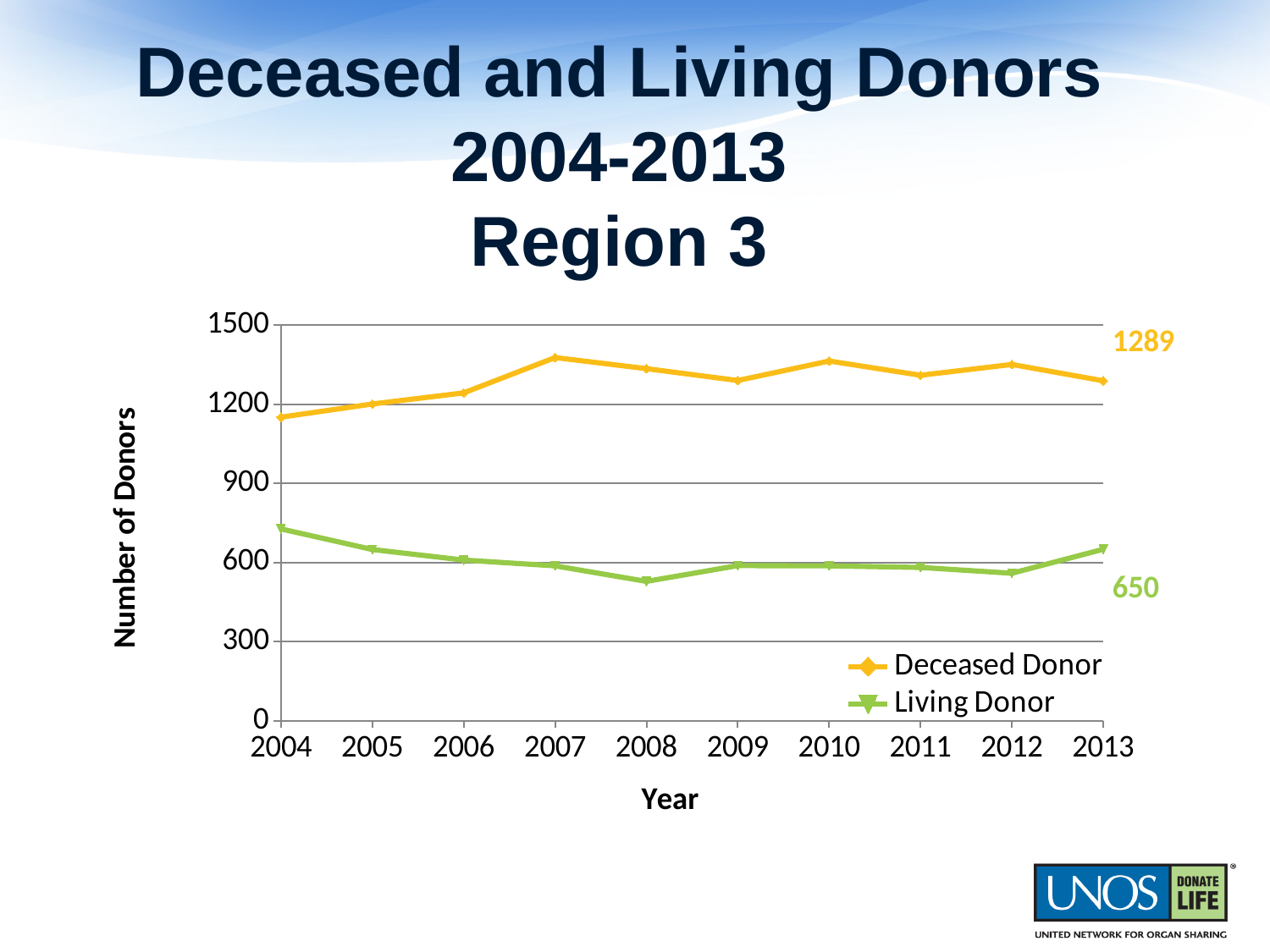
In which year is the Deceased Donor value lowest? 2004 What is the value for Living Donor in 2013? 650 What is the value for Deceased Donor in 2013? 1289 What is the difference between the Deceased Donor and Living Donor values in 2013? 639 Does the Living Donor line rise or fall from 2004 to 2008? fall Is the Living Donor value for 2008 greater or less than 600? less In which year is the Living Donor value lowest? 2008 Is the Deceased Donor value for 2004 greater or less than 1200? less What kind of chart is shown on the slide? Line chart In which year is the Living Donor value highest? 2004 How many years are plotted along the x axis? 10 How many series does the legend list? 2